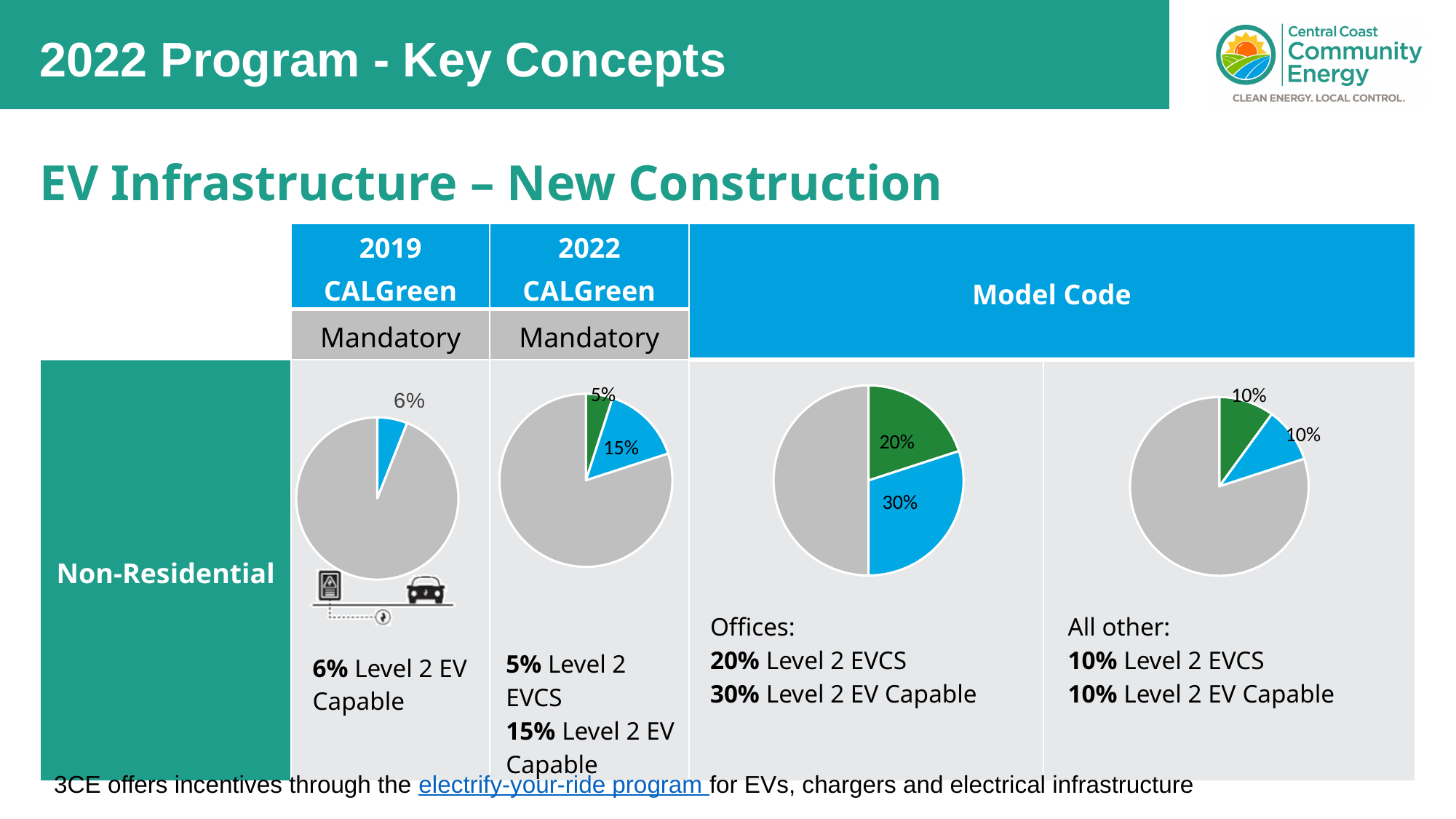
What kind of charts are shown in the Non-Residential row of the table? Pie charts How many pie charts are shown on the slide? 4 In the 2022 CALGreen Mandatory pie chart, what percentage is shown for Level 2 EVCS (green slice)? 5% Which pie chart on the slide has the largest labelled slice? Model Code Offices (30%) In the 2022 CALGreen Mandatory pie chart, what percentage is shown for Level 2 EV Capable (blue slice)? 15% In the Model Code All other pie chart, what percentage is shown for Level 2 EVCS? 10% In the 2019 CALGreen Mandatory pie chart, what percentage is labelled on the blue slice? 6% In the 2022 CALGreen Mandatory pie chart, which is larger: the Level 2 EVCS slice or the Level 2 EV Capable slice? Level 2 EV Capable In the Model Code Offices pie chart, what is the difference between the Level 2 EV Capable share and the Level 2 EVCS share? 10% In the Model Code Offices pie chart, what percentage is shown for Level 2 EV Capable? 30% In the Model Code Offices pie chart, what is the combined share of the Level 2 EVCS and Level 2 EV Capable slices? 50% In the Model Code Offices pie chart, what percentage is shown for Level 2 EVCS? 20%